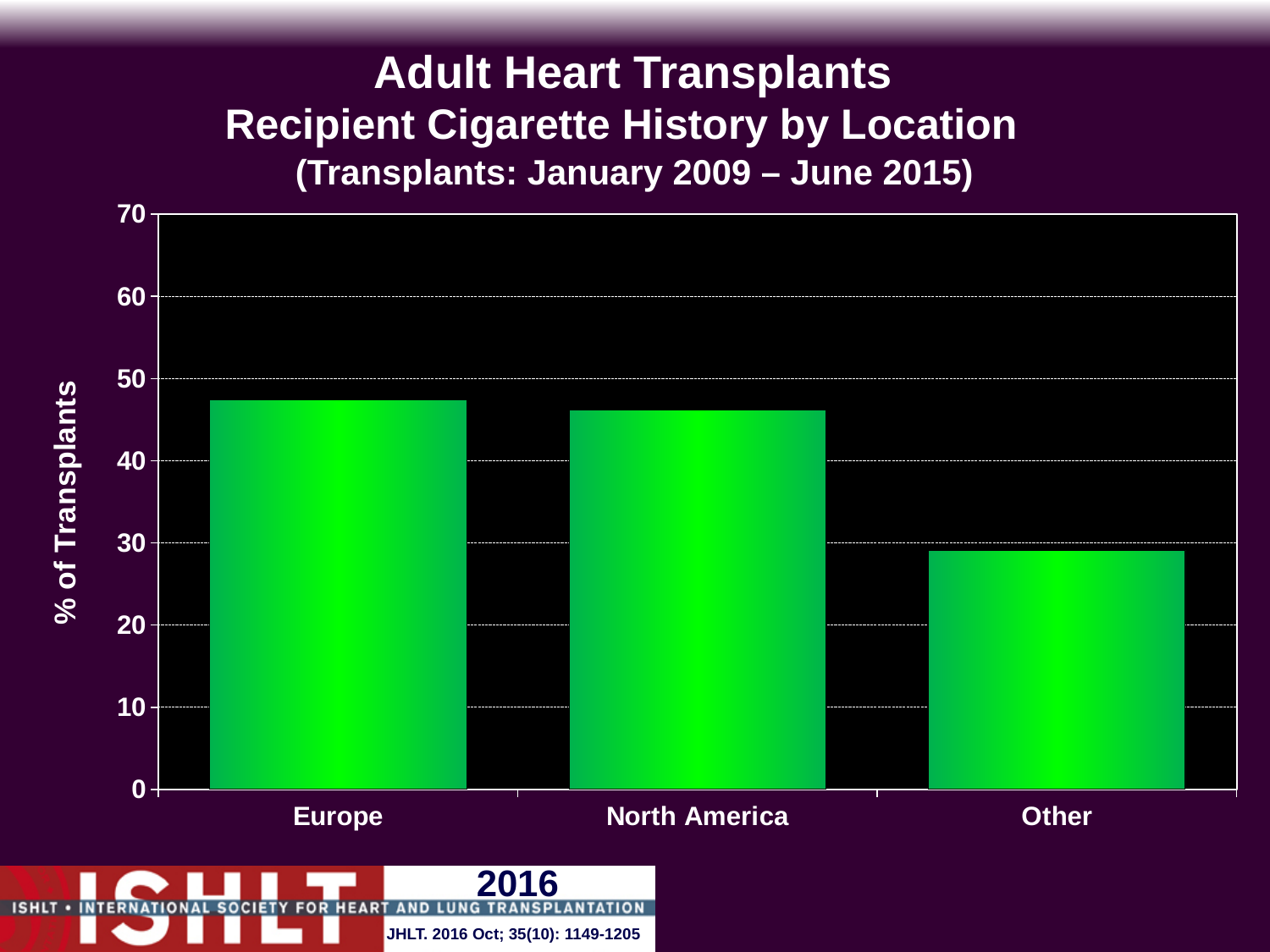
Is the value for North America greater or less than 40? greater Is the value for Europe greater or less than 40? greater Which is larger, the value for Europe or the value for Other? Europe Is the value for North America greater or less than 50? less Which is larger, the value for North America or the value for Other? North America What is the label of the y axis? % of Transplants What kind of chart is shown on the slide? bar chart How many location categories are shown on the x axis? 3 Which location has the lowest % of transplants? Other